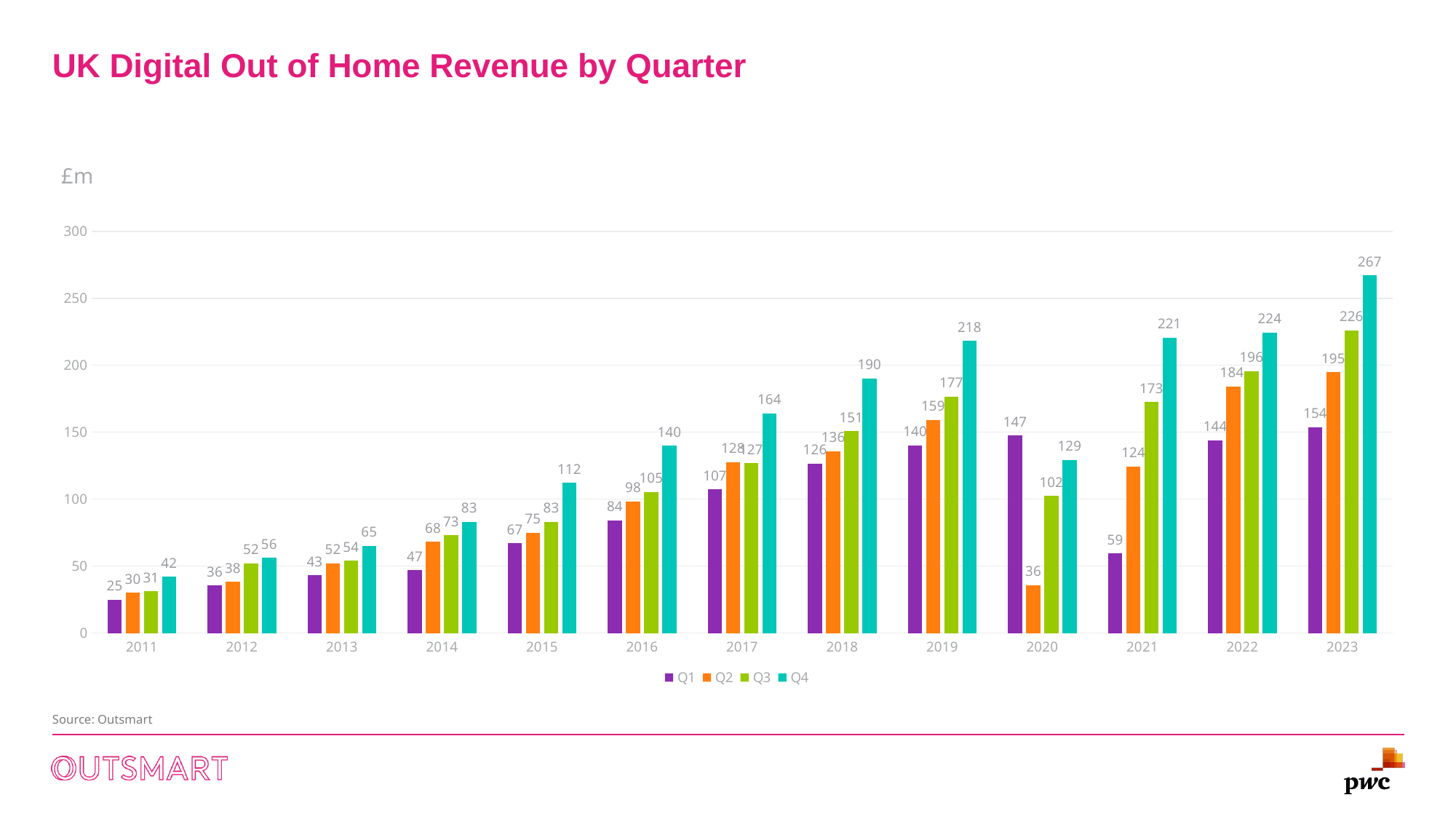
How many series does the legend list? 4 What unit is shown on the y axis? £m Which year has the highest Q4 value? 2023 How many years are shown on the x axis? 13 Which is larger, the Q2 value for 2020 or the Q2 value for 2019? Q2 2019 What is the difference between the Q4 and Q1 values for 2021? 162 Which year has the lowest Q1 value? 2011 What is the Q2 value for 2021? 124 What is the Q1 value for 2020? 147 What is the Q4 value for 2023? 267 What kind of chart is shown? bar chart Is the Q3 value for 2022 greater or less than 150? greater